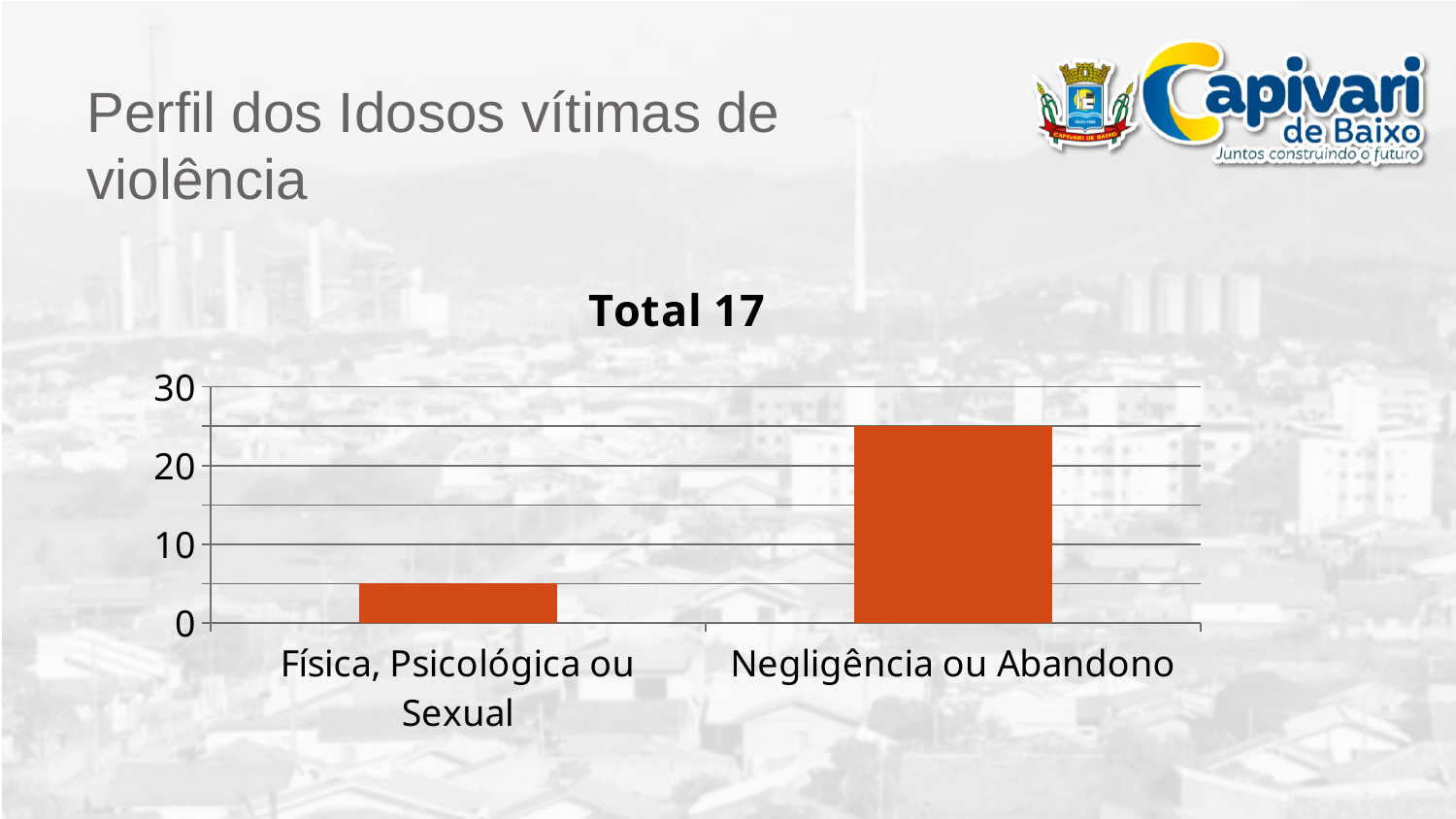
What is the highest value labelled on the vertical axis? 30 Which category has the highest bar? Negligência ou Abandono How many categories are shown on the x axis of the chart? 2 Is the value for Negligência ou Abandono greater or less than 20? greater Is the value for Negligência ou Abandono greater or less than 30? less Which is larger, the value for Física, Psicológica ou Sexual or the value for Negligência ou Abandono? Negligência ou Abandono Which category has the lowest bar? Física, Psicológica ou Sexual Is the value for Física, Psicológica ou Sexual greater or less than 10? less What is the title of the chart? Total 17 What kind of chart is shown on the slide? bar chart